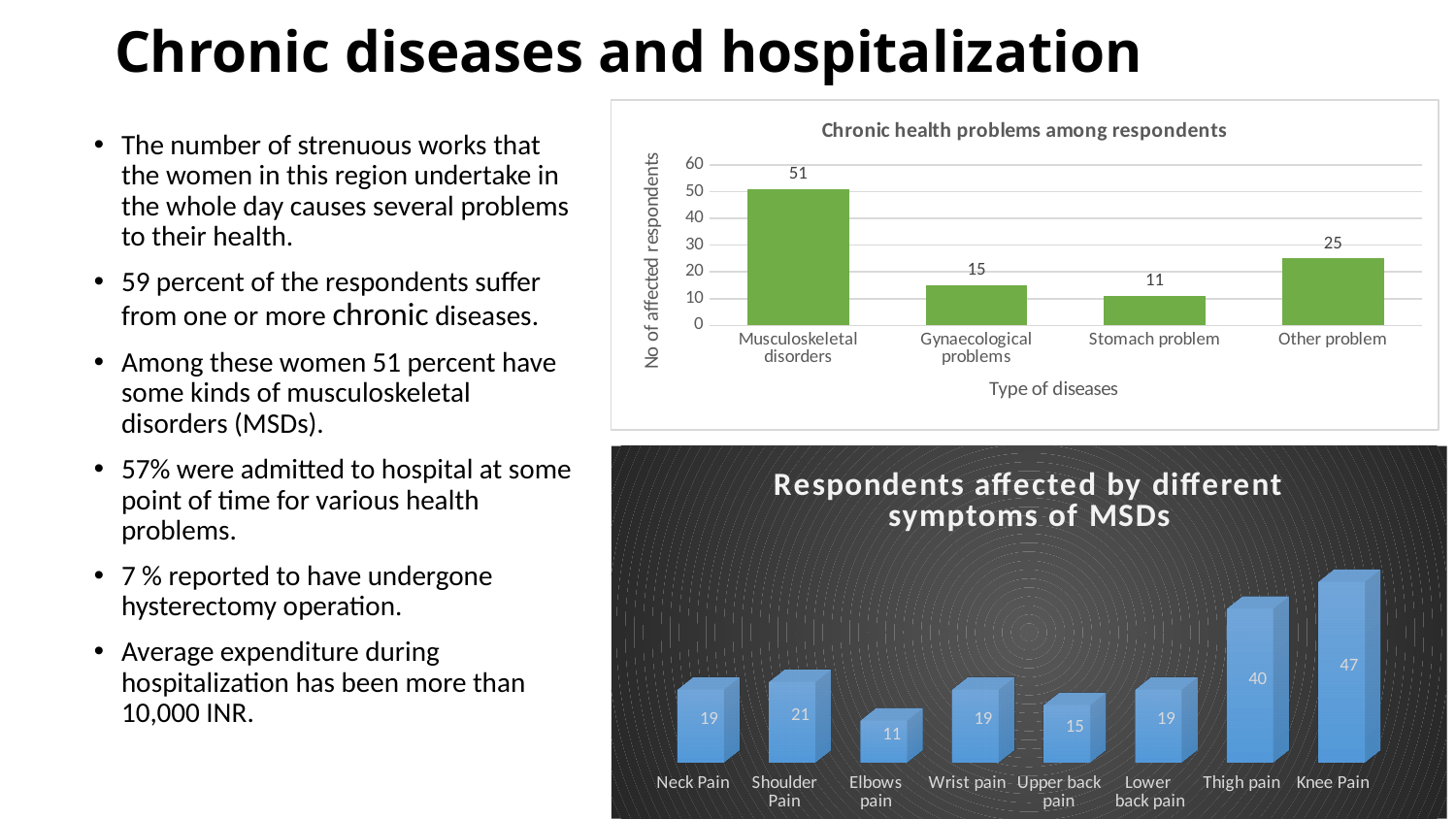
In the 'Respondents affected by different symptoms of MSDs' chart, what is the difference between Knee Pain and Thigh pain? 7 In the 'Chronic health problems among respondents' chart, what is the difference between Musculoskeletal disorders and Other problem? 26 In the 'Chronic health problems among respondents' chart, what is the value for Musculoskeletal disorders? 51 In the 'Chronic health problems among respondents' chart, which type of disease has the lowest number of affected respondents? Stomach problem In the 'Respondents affected by different symptoms of MSDs' chart, what is the value for Knee Pain? 47 In the 'Respondents affected by different symptoms of MSDs' chart, which symptom has the fewest respondents? Elbows pain In the 'Respondents affected by different symptoms of MSDs' chart, how many symptoms are shown? 8 In the 'Chronic health problems among respondents' chart, what is the label of the vertical axis? No of affected respondents In the 'Chronic health problems among respondents' chart, how many types of diseases are shown? 4 What kind of chart is the 'Respondents affected by different symptoms of MSDs' chart? Bar chart In the 'Respondents affected by different symptoms of MSDs' chart, which is larger: Thigh pain or Shoulder Pain? Thigh pain In the 'Chronic health problems among respondents' chart, is the value for Gynaecological problems greater or less than 20? less